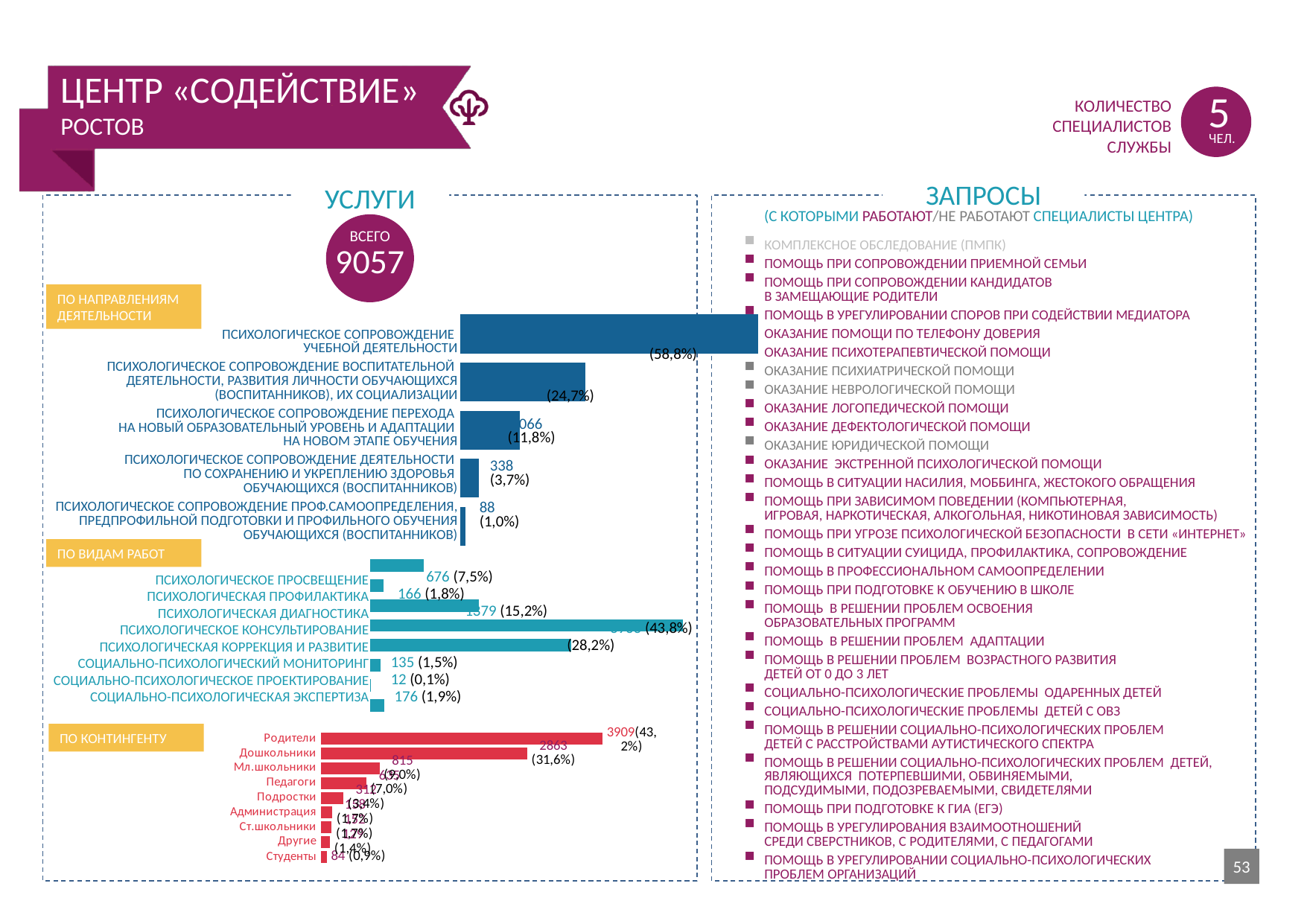
In the chart 'По направлениям деятельности', what percentage is shown for 'Психологическое сопровождение учебной деятельности'? 58,8% What kind of chart is used in the 'По контингенту' section? Bar chart In the chart 'По видам работ', what is the difference between 'Психологическое просвещение' (676) and 'Психологическая профилактика' (166)? 510 In the chart 'По направлениям деятельности', what is the difference between the value for 'сохранению и укреплению здоровья' (338) and 'проф.самоопределения' (88)? 250 In the chart 'По видам работ', which type of work has the highest value? Психологическое консультирование In the chart 'По видам работ', how many types of work are listed? 8 In the chart 'По направлениям деятельности', which direction has the lowest value? Психологическое сопровождение проф.самоопределения, предпрофильной подготовки и профильного обучения обучающихся (воспитанников) In the chart 'По направлениям деятельности', what value is shown for 'Психологическое сопровождение деятельности по сохранению и укреплению здоровья обучающихся (воспитанников)'? 338 In the chart 'По видам работ', which type of work has the lowest value? Социально-психологическое проектирование In the chart 'По видам работ', what value is shown for 'Психологическое просвещение'? 676 In the chart 'По контингенту', which is larger, the value for 'Родители' or for 'Дошкольники'? Родители In the chart 'По контингенту', what value is shown for 'Родители'? 3909